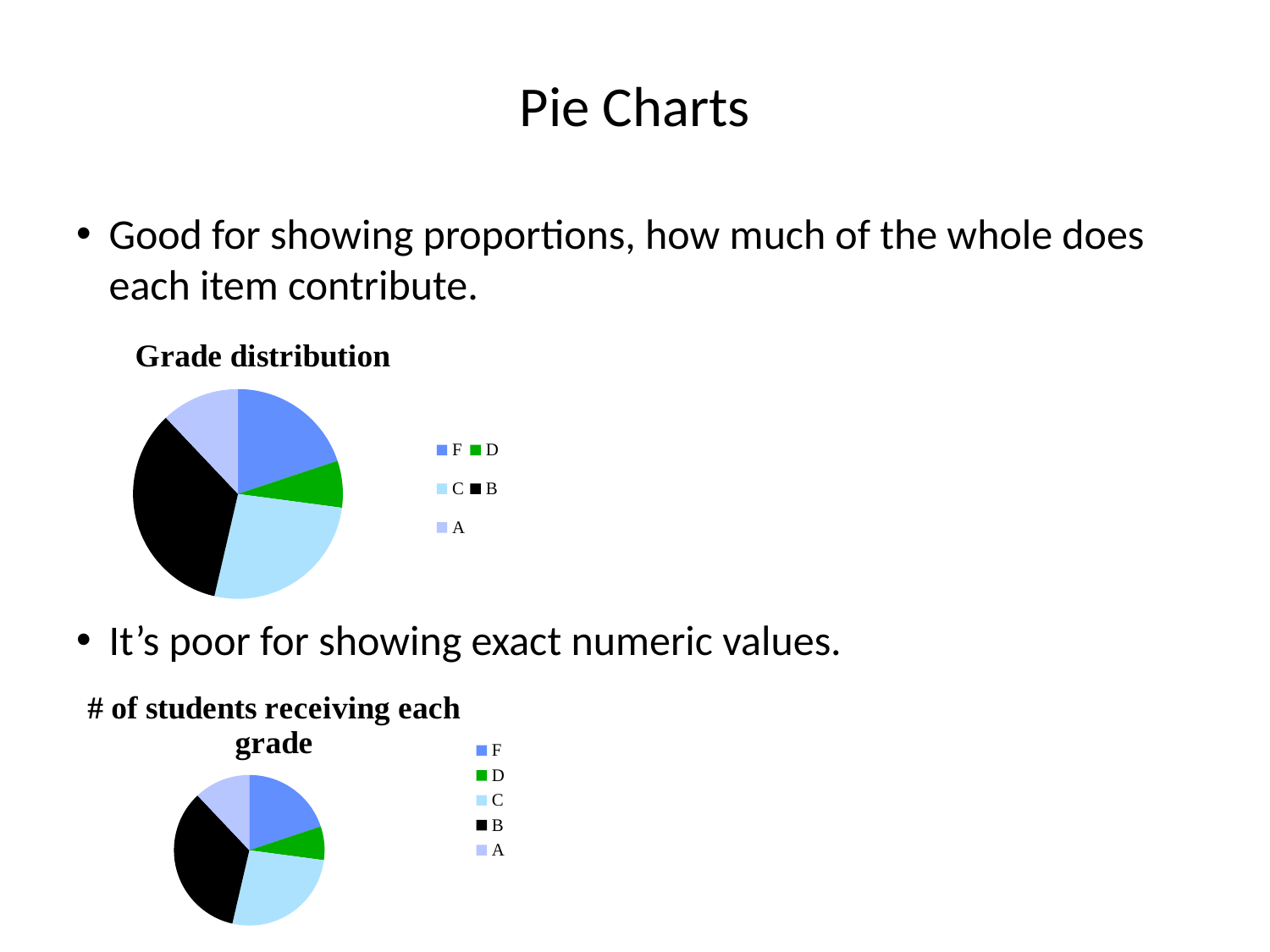
In the 'Grade distribution' chart, which slice is larger, B or C? B In the 'Grade distribution' chart, what colour is the slice for grade B? black What is the title of the lower pie chart on the slide? # of students receiving each grade How many slices does the 'Grade distribution' pie chart have? 5 In the 'Grade distribution' chart, which grade has the smallest slice? D In the 'Grade distribution' chart, which slice is larger, C or D? C What kind of chart is the 'Grade distribution' chart? pie chart In the '# of students receiving each grade' chart, which grade has the smallest slice? D How many entries does the legend of the '# of students receiving each grade' chart list? 5 In the 'Grade distribution' chart, which grade has the largest slice? B In the '# of students receiving each grade' chart, which grade has the largest slice? B How many entries does the legend of the 'Grade distribution' chart list? 5